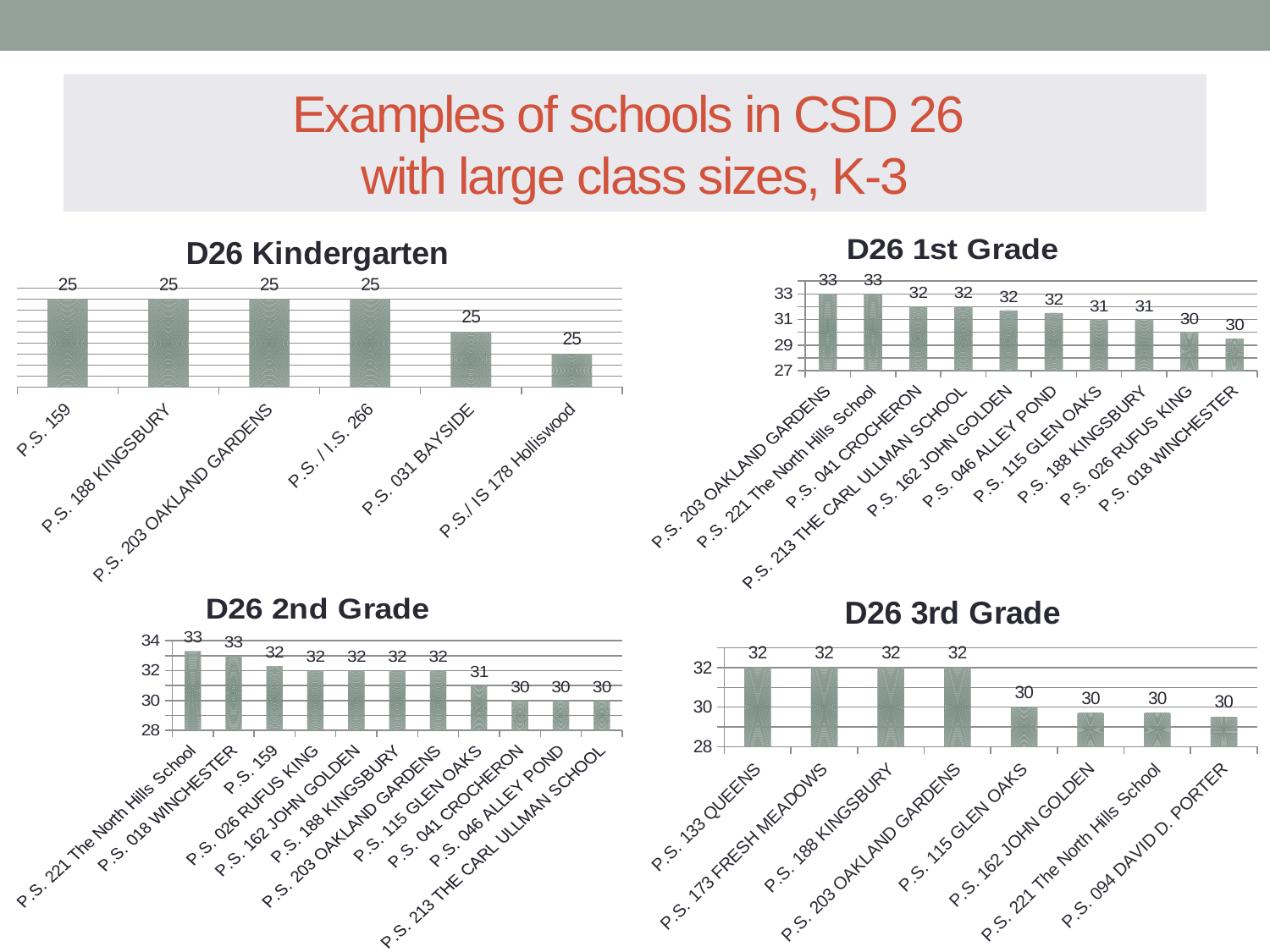
In the D26 Kindergarten chart, what is the value for P.S. 031 BAYSIDE? 25 In the D26 Kindergarten chart, how many schools are shown? 6 In the D26 2nd Grade chart, do the values rise or fall from left to right? fall In the D26 3rd Grade chart, what is the difference between the values for P.S. 133 QUEENS and P.S. 094 DAVID D. PORTER? 2 In the D26 1st Grade chart, which is larger, the value for P.S. 221 The North Hills School or the value for P.S. 026 RUFUS KING? P.S. 221 The North Hills School In the D26 1st Grade chart, what is the value for P.S. 018 WINCHESTER? 30 In the D26 2nd Grade chart, what is the value for P.S. 115 GLEN OAKS? 31 What kind of chart is the D26 3rd Grade chart? bar chart In the D26 3rd Grade chart, what is the value for P.S. 173 FRESH MEADOWS? 32 In the D26 1st Grade chart, what is the difference between the values for P.S. 203 OAKLAND GARDENS and P.S. 018 WINCHESTER? 3 In the D26 2nd Grade chart, how many schools are shown? 11 In the D26 1st Grade chart, what is the value for P.S. 041 CROCHERON? 32